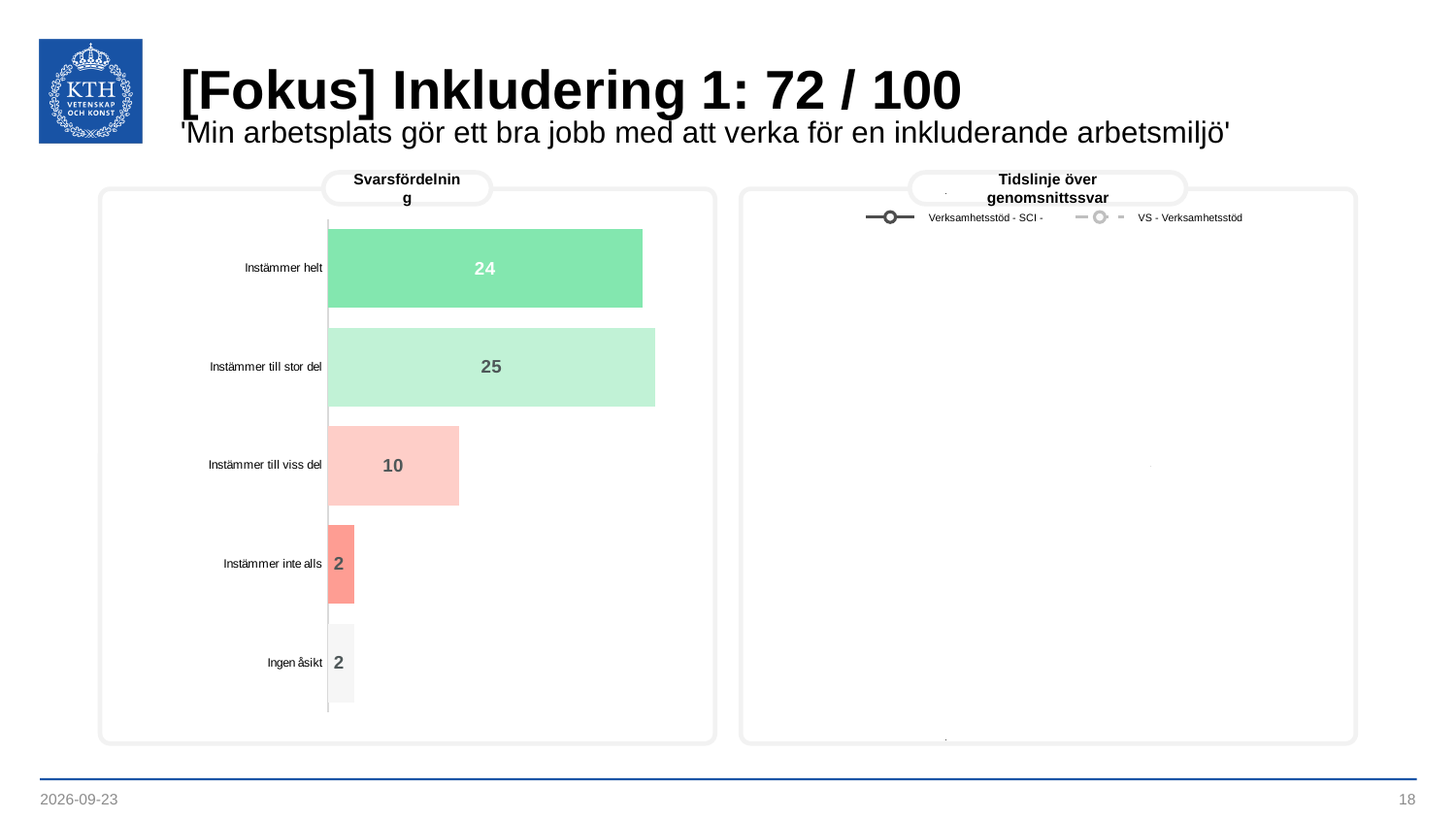
In the 'Svarsfördelning' chart, what is the total of all five category values? 63 In the 'Svarsfördelning' chart, what is the value for 'Instämmer inte alls'? 2 In the 'Svarsfördelning' chart, what is the value for 'Instämmer till stor del'? 25 In the 'Svarsfördelning' chart, which category has the highest value? Instämmer till stor del How many categories are shown in the 'Svarsfördelning' chart? 5 In the 'Svarsfördelning' chart, what is the value for 'Instämmer till viss del'? 10 In the 'Svarsfördelning' chart, which is larger: 'Instämmer helt' or 'Instämmer till stor del'? Instämmer till stor del In the 'Svarsfördelning' chart, what is the difference between 'Instämmer till stor del' and 'Instämmer till viss del'? 15 How many series does the legend of the 'Tidslinje över genomsnittssvar' chart list? 2 What kind of chart is the 'Svarsfördelning' chart? Bar chart In the 'Svarsfördelning' chart, what is the value for 'Ingen åsikt'? 2 In the 'Svarsfördelning' chart, what is the value for 'Instämmer helt'? 24